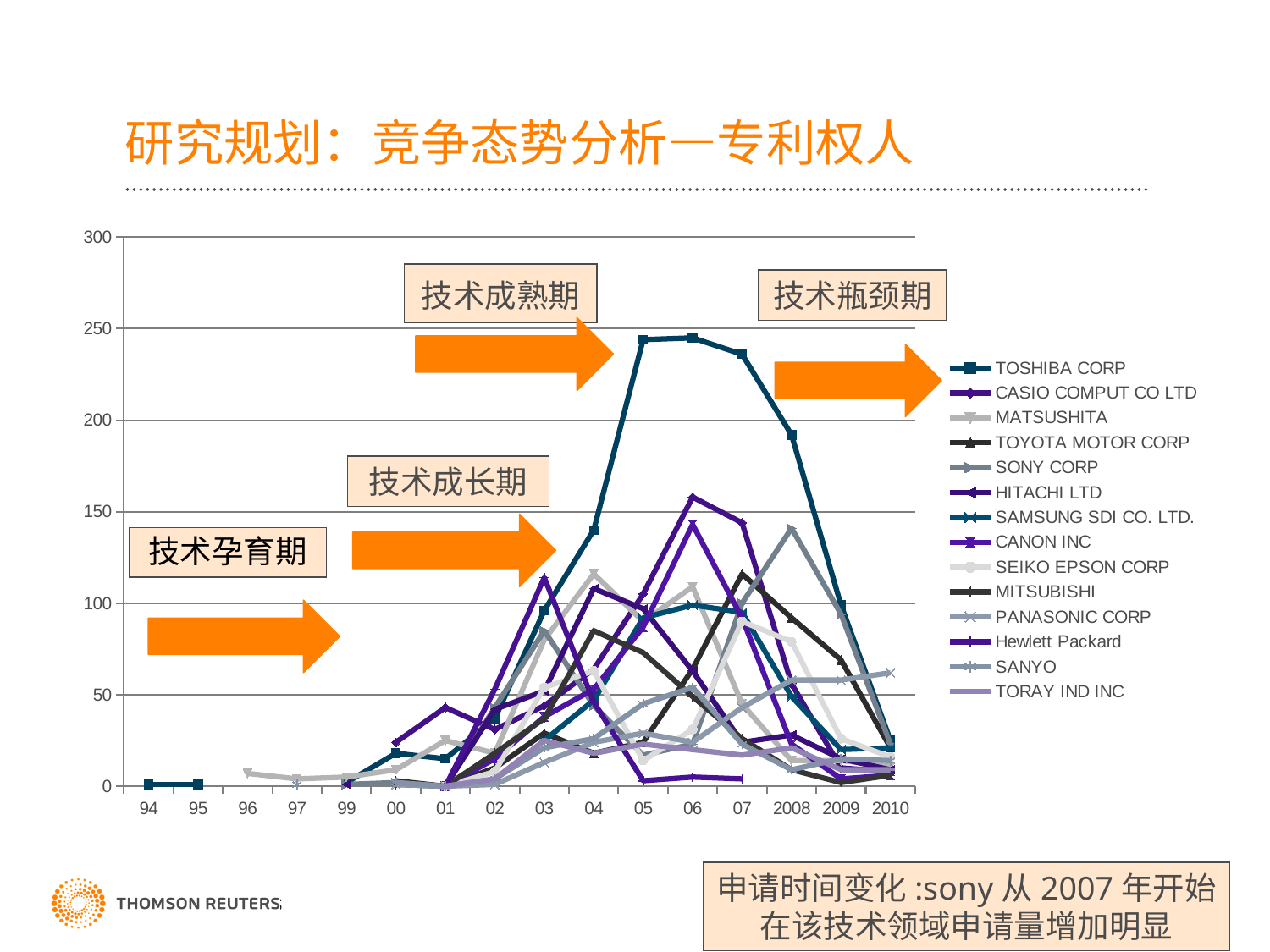
How many year categories are shown on the x axis? 16 Is the value for TOSHIBA CORP in 05 greater or less than 200? greater Do the values for TOSHIBA CORP rise or fall from 06 to 2010? fall Which series is listed first in the legend? TOSHIBA CORP What is the highest value shown on the y axis? 300 What kind of chart is shown on the slide? line chart Which series reaches the highest value on the chart? TOSHIBA CORP Is the value for TOSHIBA CORP in 2008 greater or less than 150? greater Is the value for TOSHIBA CORP in 2010 greater or less than 50? less Which is larger in 06, the value for TOSHIBA CORP or the value for HITACHI LTD? TOSHIBA CORP How many series does the legend list? 14